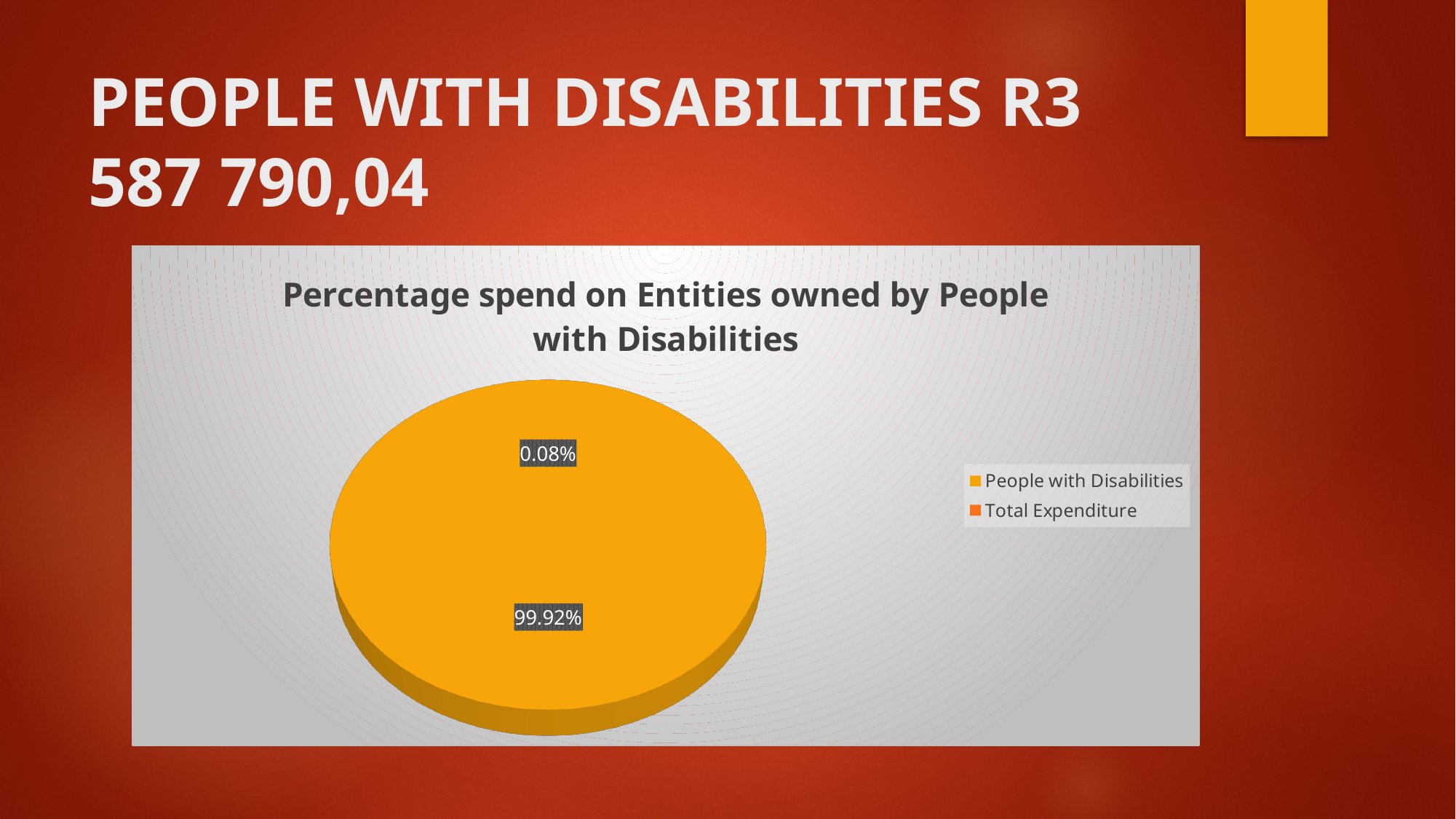
What are the two legend entries listed on the chart? People with Disabilities; Total Expenditure Which category has the smallest share of the pie? Total Expenditure Which is larger, the share for People with Disabilities or the share for Total Expenditure? People with Disabilities What kind of chart is shown on the slide? Pie chart How many entries does the chart legend list? 2 What is the title of the chart? Percentage spend on Entities owned by People with Disabilities Which category has the largest share of the pie? People with Disabilities What do the two percentage labels on the pie add up to? 100% How many slices does the pie chart have? 1